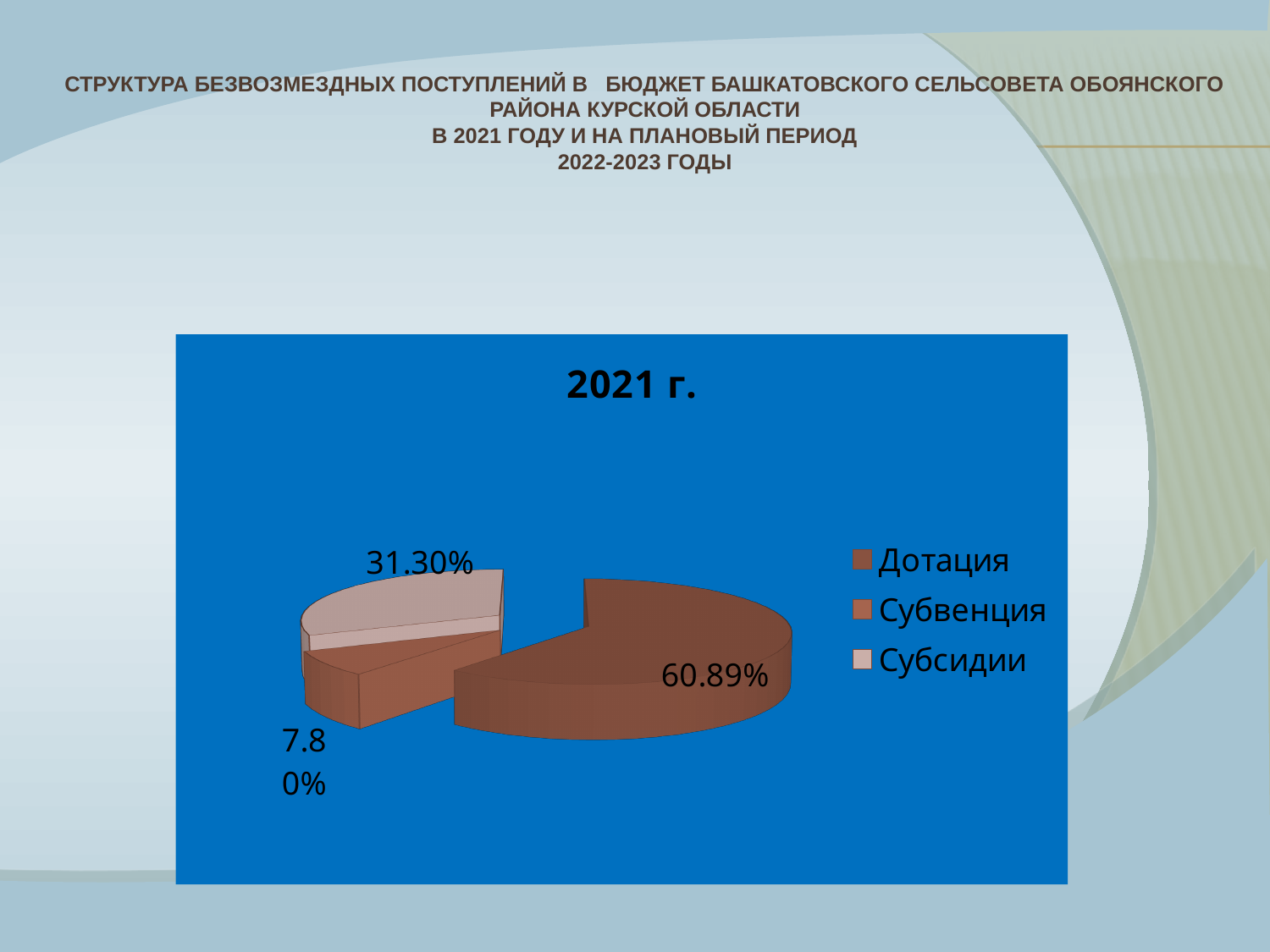
What share of the pie does Дотация have? 60.89% What is the title of the chart? 2021 г. How many slices does the pie chart have? 3 How many entries does the legend list? 3 Which category has the smallest slice of the pie? Субвенция What share of the pie does Субсидии have? 31.30% What kind of chart is shown on the slide? pie chart What share of the pie does Субвенция have? 7.80% Which legend entry is listed first? Дотация Which category has the largest slice of the pie? Дотация Which is larger, the share for Субсидии or the share for Субвенция? Субсидии What is the difference between the share for Дотация and the share for Субсидии? 29.59%